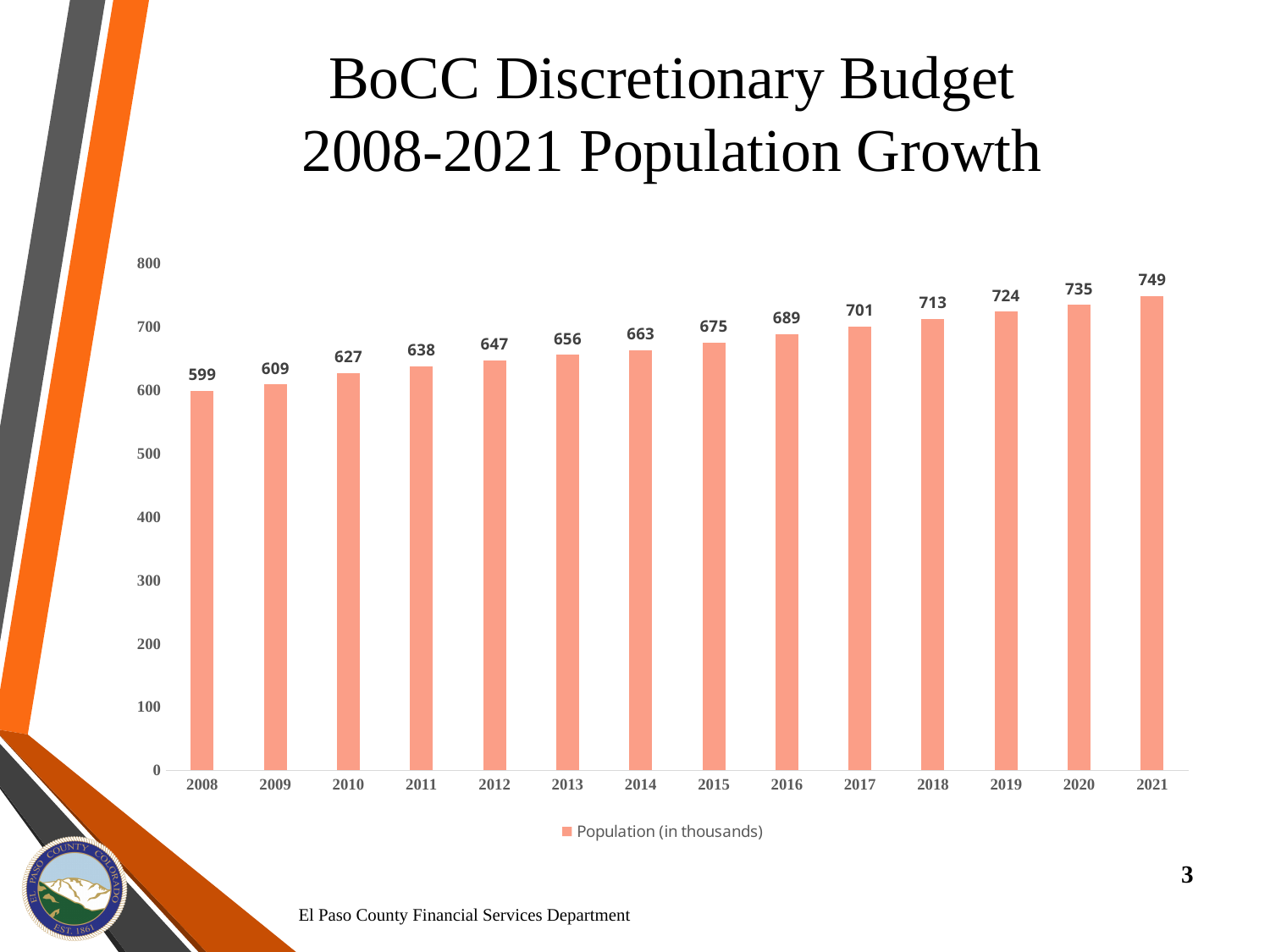
Which year has the highest population value? 2021 What is the population (in thousands) shown for 2021? 749 Do the population values rise or fall from 2008 to 2021? Rise Which year has a larger population value, 2010 or 2017? 2017 What is the difference between the population values for 2013 and 2012? 9 What is the difference between the population values for 2021 and 2008? 150 What is the population (in thousands) shown for 2008? 599 Which year has the lowest population value? 2008 How many years are shown on the x axis? 14 What kind of chart is shown on the slide? Bar chart Is the value for 2016 greater or less than 600? greater What is the population (in thousands) shown for 2015? 675